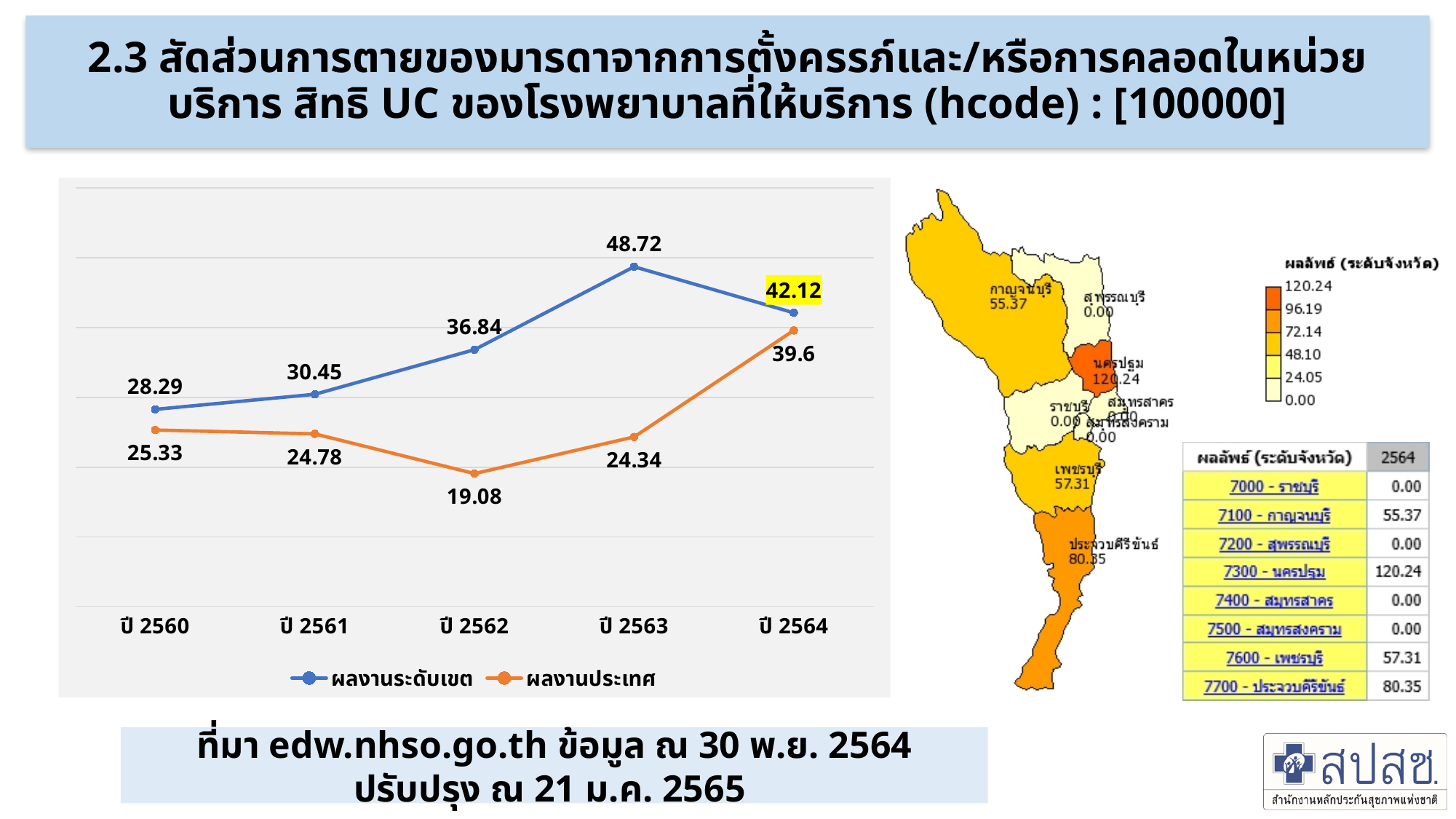
In the line chart, which year has the highest value for ผลงานระดับเขต? ปี 2563 In the line chart, which colour is used for the ผลงานประเทศ series? Orange In the line chart, which year has the lowest value for ผลงานประเทศ? ปี 2562 In the line chart, does ผลงานระดับเขต rise or fall from ปี 2560 to ปี 2563? Rise In the line chart, what is the value of ผลงานประเทศ for ปี 2562? 19.08 In the line chart, what is the difference between ผลงานระดับเขต and ผลงานประเทศ in ปี 2564? 2.52 In the line chart, what is the value of ผลงานระดับเขต for ปี 2563? 48.72 How many years are shown on the x axis of the line chart? 5 How many series does the legend of the line chart list? 2 In the line chart, what is the value of ผลงานระดับเขต for ปี 2564? 42.12 What type of chart is shown on the left of the slide? Line chart In the line chart, which series has the larger value in ปี 2560, ผลงานระดับเขต or ผลงานประเทศ? ผลงานระดับเขต